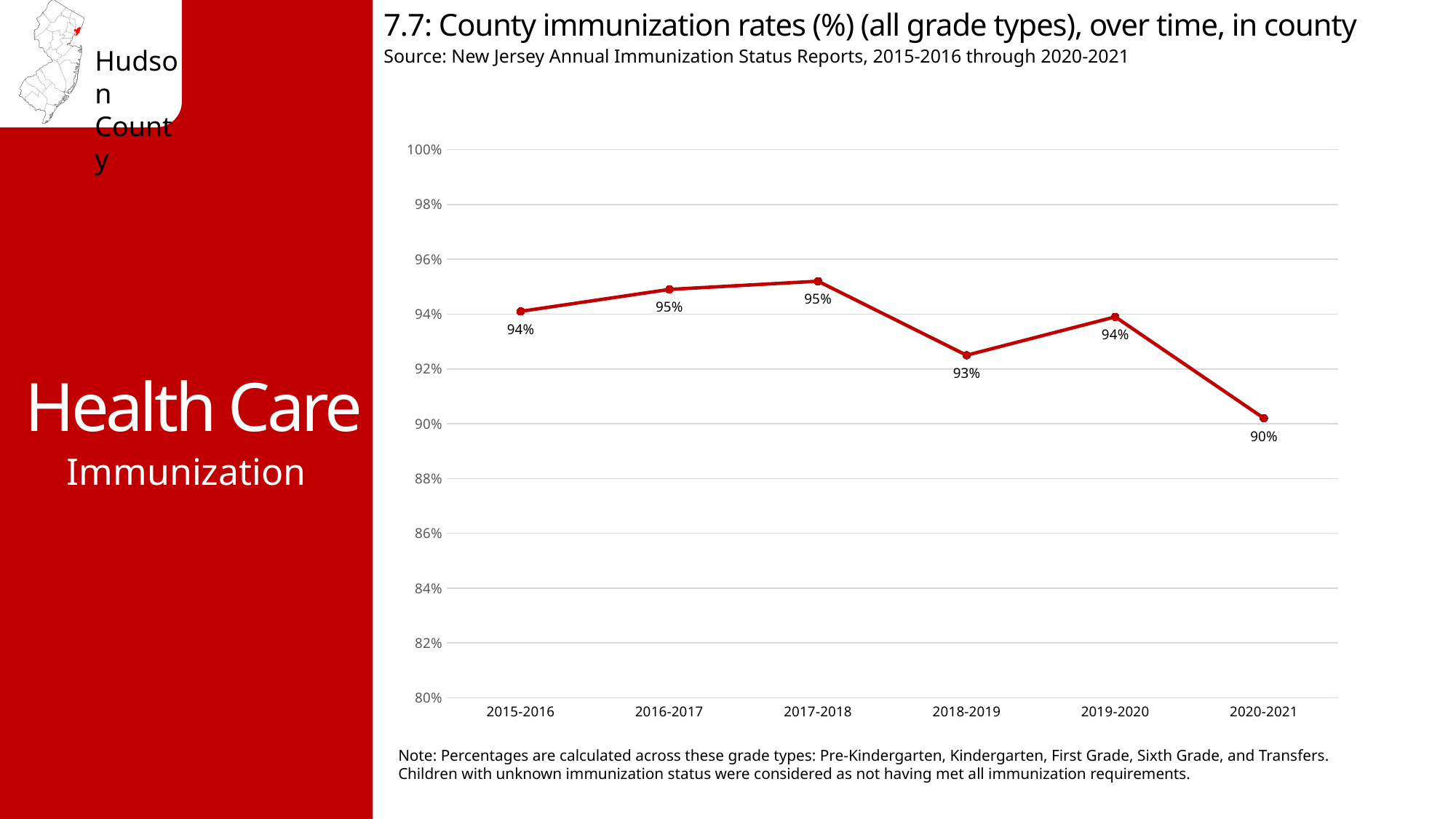
How many school years are plotted on the chart? 6 Is the immunization rate for 2017-2018 greater or less than 94%? greater What is the county immunization rate for 2015-2016? 94% Does the immunization rate rise or fall from 2017-2018 to 2020-2021? fall Is the immunization rate for 2020-2021 greater or less than 92%? less Which year has a higher immunization rate, 2015-2016 or 2018-2019? 2015-2016 What is the county immunization rate for 2018-2019? 93% What kind of chart is shown on the slide? line chart What is the county immunization rate for 2020-2021? 90% Which school year has the lowest immunization rate? 2020-2021 What is the difference between the immunization rate in 2017-2018 and in 2020-2021? 5 percentage points What is the source cited for the chart data? New Jersey Annual Immunization Status Reports, 2015-2016 through 2020-2021